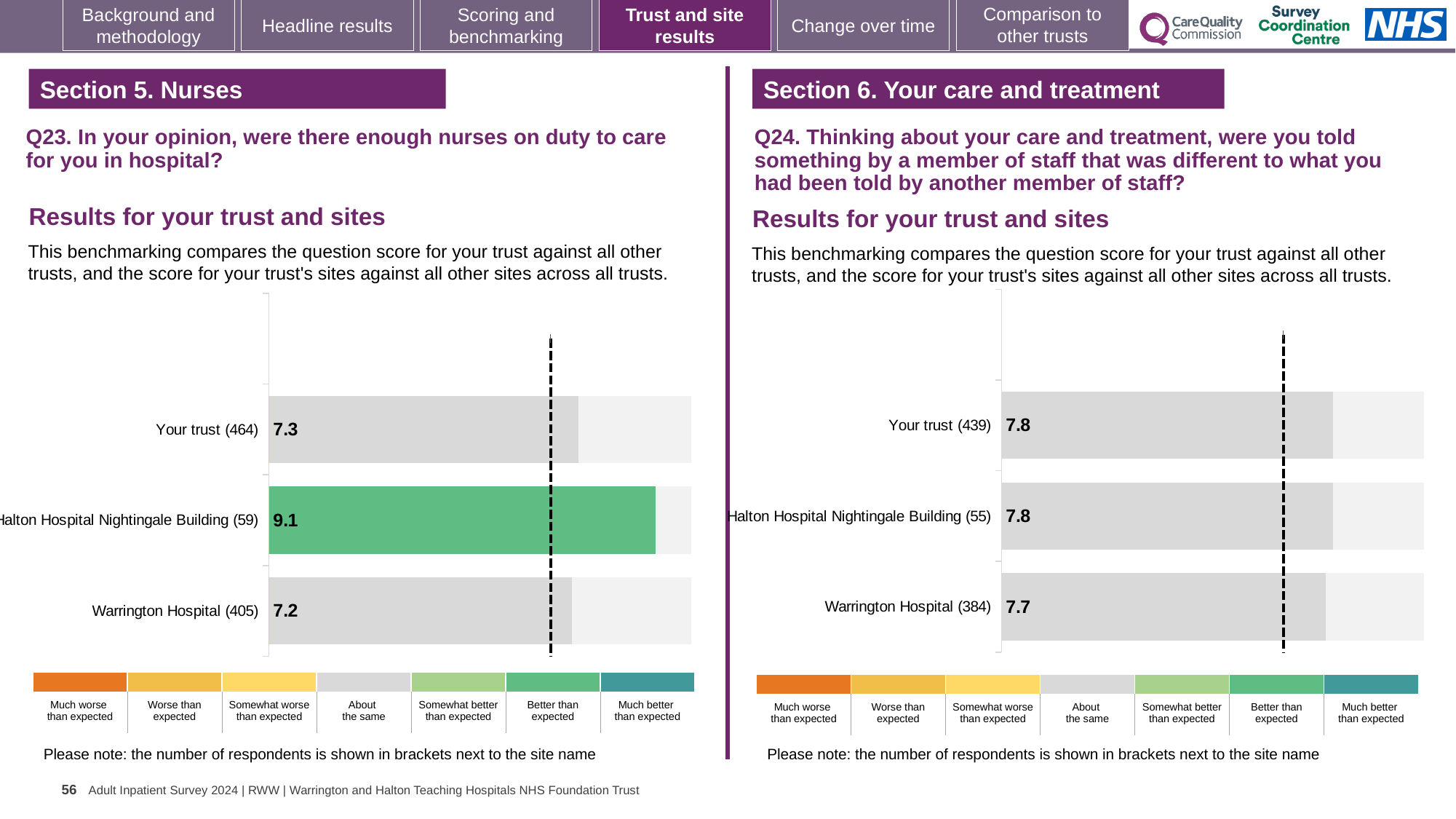
What type of chart is used on the left for Q23? Bar chart In the Q23 chart on the left, what is the score for Warrington Hospital (405)? 7.2 In the Q23 chart on the left, what is the difference between the scores for Halton Hospital Nightingale Building (59) and Warrington Hospital (405)? 1.9 In the Q23 chart on the left, what is the score for Your trust (464)? 7.3 In the Q23 chart on the left, which is larger: the score for Halton Hospital Nightingale Building (59) or the score for Your trust (464)? Halton Hospital Nightingale Building (59) In the Q23 chart on the left, how many bars are plotted? 3 In the Q23 chart on the left, which site or trust has the highest score? Halton Hospital Nightingale Building (59) In the Q24 chart on the right, what is the difference between the scores for Halton Hospital Nightingale Building (55) and Warrington Hospital (384)? 0.1 In the Q24 chart on the right, what is the score for Your trust (439)? 7.8 In the Q23 chart on the left, which bar is coloured green? Halton Hospital Nightingale Building (59) In the Q24 chart on the right, what is the score for Warrington Hospital (384)? 7.7 In the Q23 chart on the left, what is the score for Halton Hospital Nightingale Building (59)? 9.1